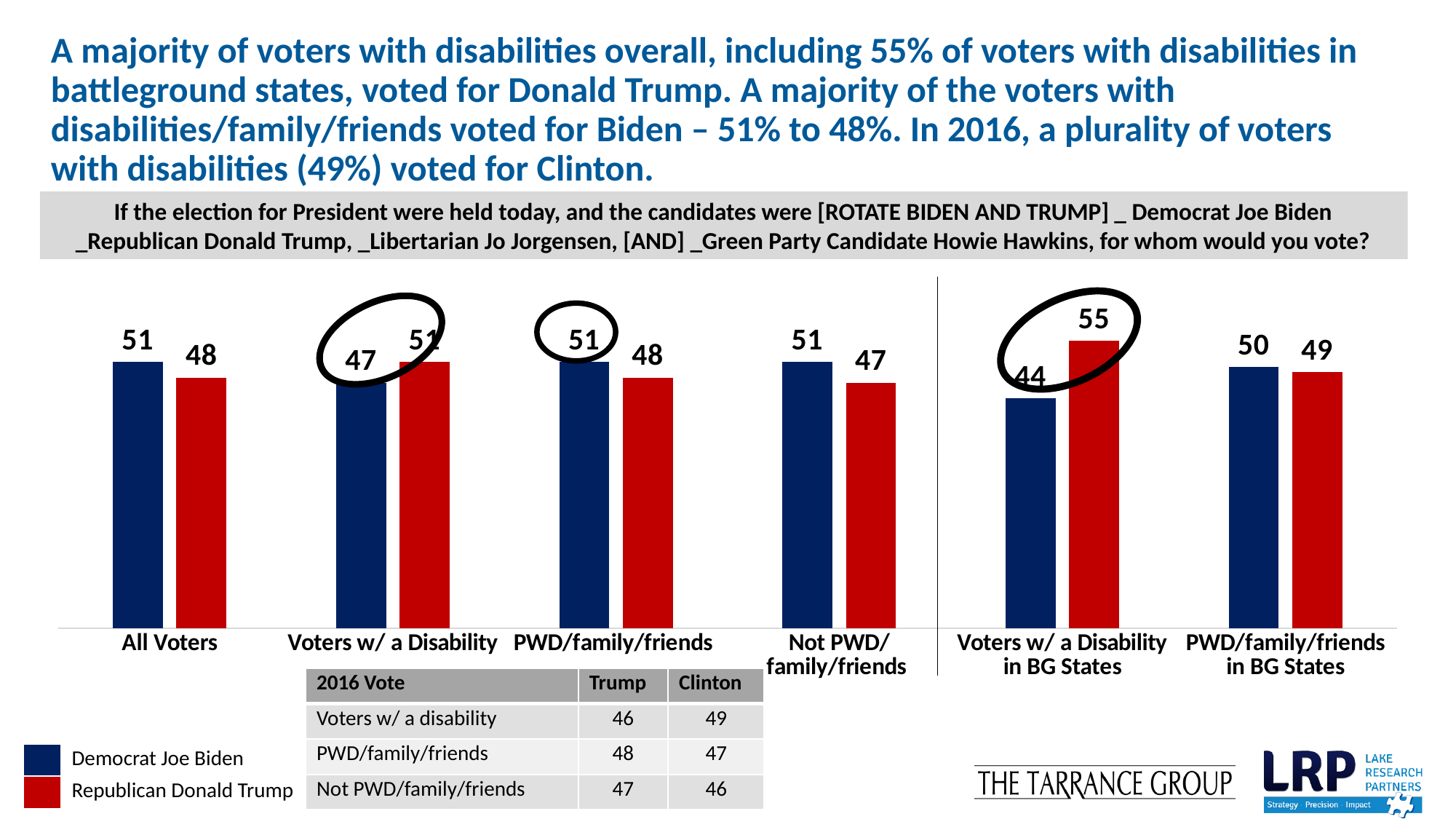
What is the value for Democrat Joe Biden among All Voters? 51 What kind of chart is shown on the slide? Bar chart What is the value for Democrat Joe Biden among PWD/family/friends in BG States? 50 Among Voters w/ a Disability, which is larger: the value for Biden or the value for Trump? Trump What is the value for Republican Donald Trump among Voters w/ a Disability? 51 What is the value for Republican Donald Trump among Voters w/ a Disability in BG States? 55 Which category has the highest value for Republican Donald Trump? Voters w/ a Disability in BG States Which category has the lowest value for Democrat Joe Biden? Voters w/ a Disability in BG States How many categories are shown on the x axis of the chart? 6 What is the difference between the Trump and Biden values among Voters w/ a Disability in BG States? 11 How many series does the legend list? 2 What is the difference between the Biden and Trump values among Not PWD/family/friends? 4